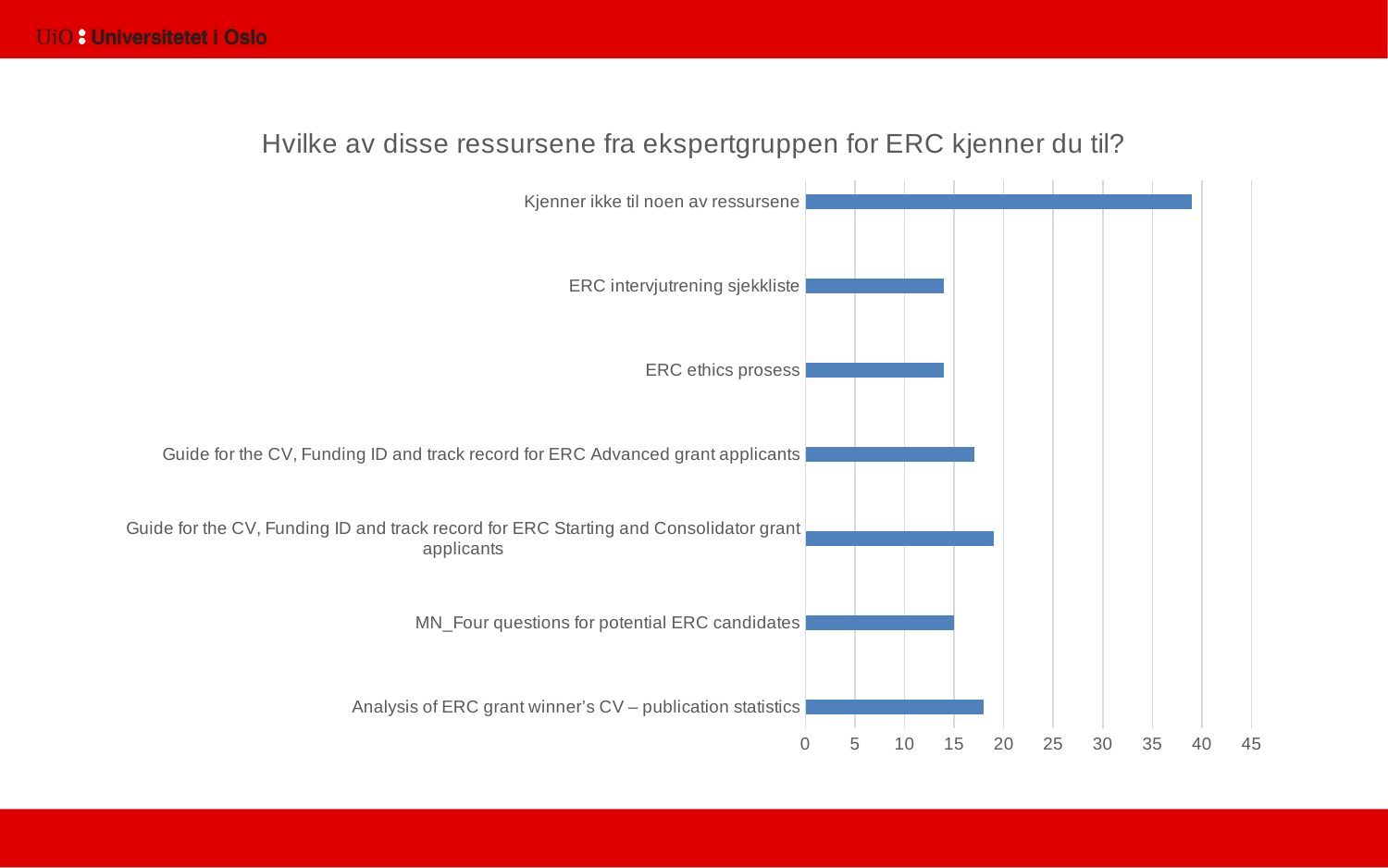
Is the value for "ERC ethics prosess" greater or less than 15? less What kind of chart is shown on the slide? Bar chart Which is larger: the value for "Guide for the CV, Funding ID and track record for ERC Starting and Consolidator grant applicants" or the value for "MN_Four questions for potential ERC candidates"? Guide for the CV, Funding ID and track record for ERC Starting and Consolidator grant applicants Which is larger: the value for "Kjenner ikke til noen av ressursene" or the value for "Analysis of ERC grant winner's CV – publication statistics"? Kjenner ikke til noen av ressursene Is the value for "Analysis of ERC grant winner's CV – publication statistics" greater or less than 20? less Is the value for "Kjenner ikke til noen av ressursene" greater or less than 35? greater Which category has the highest value? Kjenner ikke til noen av ressursene What is the title of the chart? Hvilke av disse ressursene fra ekspertgruppen for ERC kjenner du til? How many categories (bars) does the chart show? 7